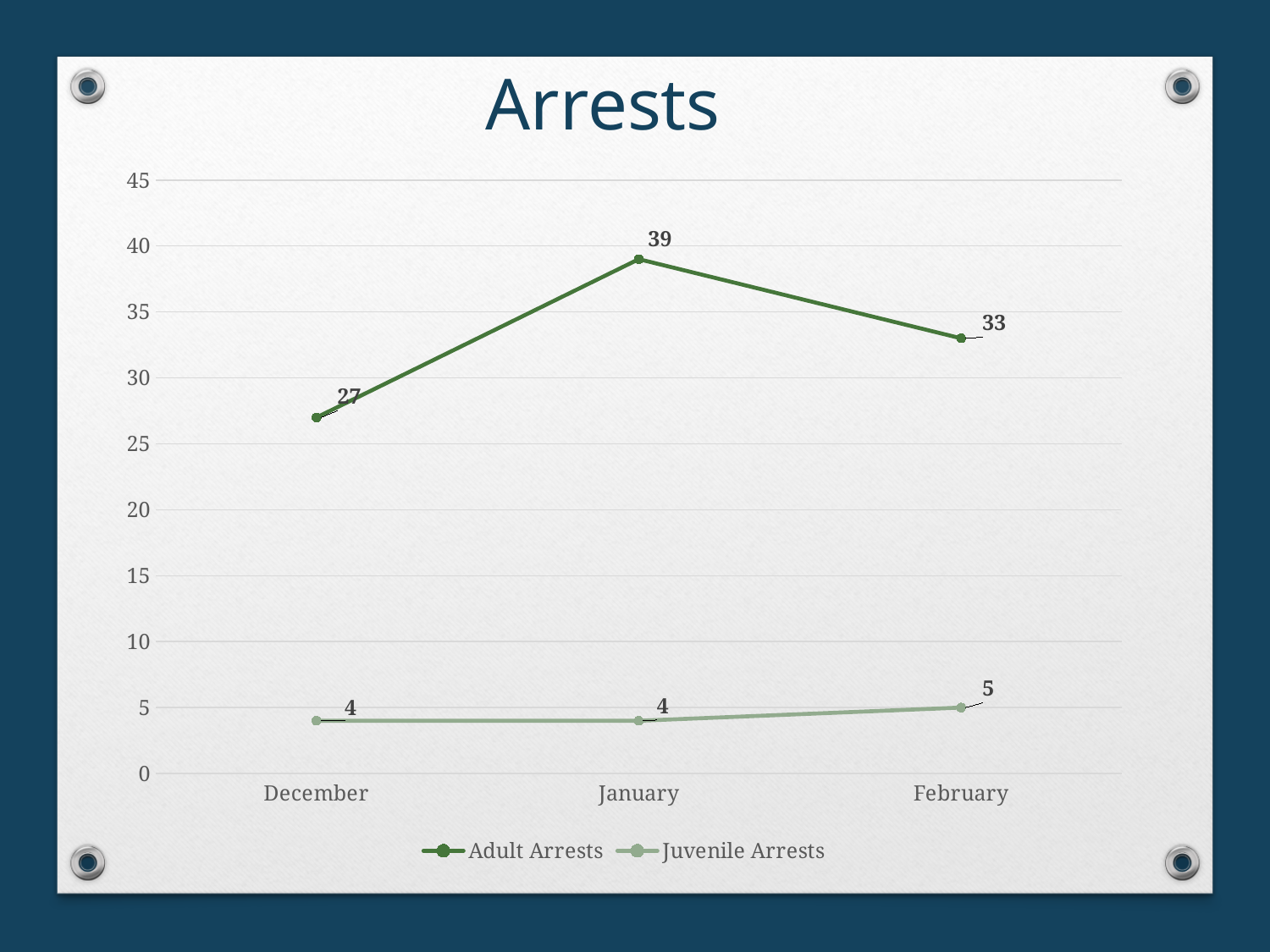
What is the value for Adult Arrests in December? 27 What is the value for Juvenile Arrests in February? 5 How many months are shown on the x axis? 3 What is the difference between Adult Arrests in January and February? 6 What is the difference between Adult Arrests and Juvenile Arrests in December? 23 In which month are Adult Arrests lowest? December How many series does the legend list? 2 In which month are Adult Arrests highest? January Which is larger: Adult Arrests in February or Adult Arrests in December? Adult Arrests in February What kind of chart is shown on the slide? Line chart What is the value for Adult Arrests in January? 39 What is the title of the chart? Arrests